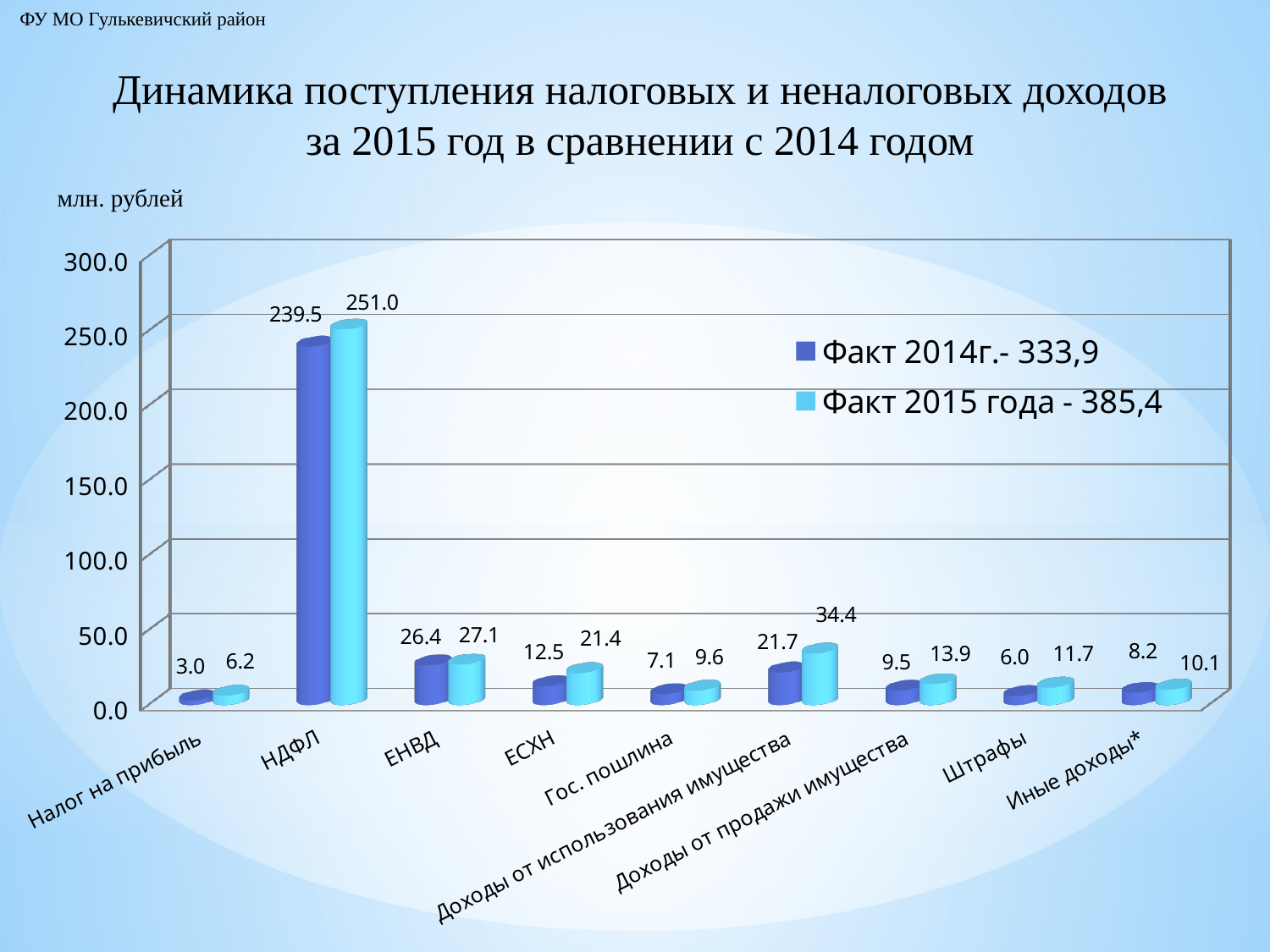
Which category has the lowest value in the Факт 2015 года series? Налог на прибыль What unit is stated above the chart? млн. рублей What is the value for ЕСХН in the Факт 2014г. series? 12.5 What kind of chart is shown on the slide? bar chart What is the value for Доходы от использования имущества in the Факт 2015 года series? 34.4 What is the difference between the Факт 2015 года and Факт 2014г. values for НДФЛ? 11.5 How many series does the legend list? 2 Which category has the highest value in the Факт 2014г. series? НДФЛ Is the Факт 2014г. value for НДФЛ greater or less than 200.0? greater What is the value for НДФЛ in the Факт 2015 года series? 251.0 Which is larger for Штрафы: the Факт 2014г. value or the Факт 2015 года value? Факт 2015 года How many categories are shown on the x axis? 9